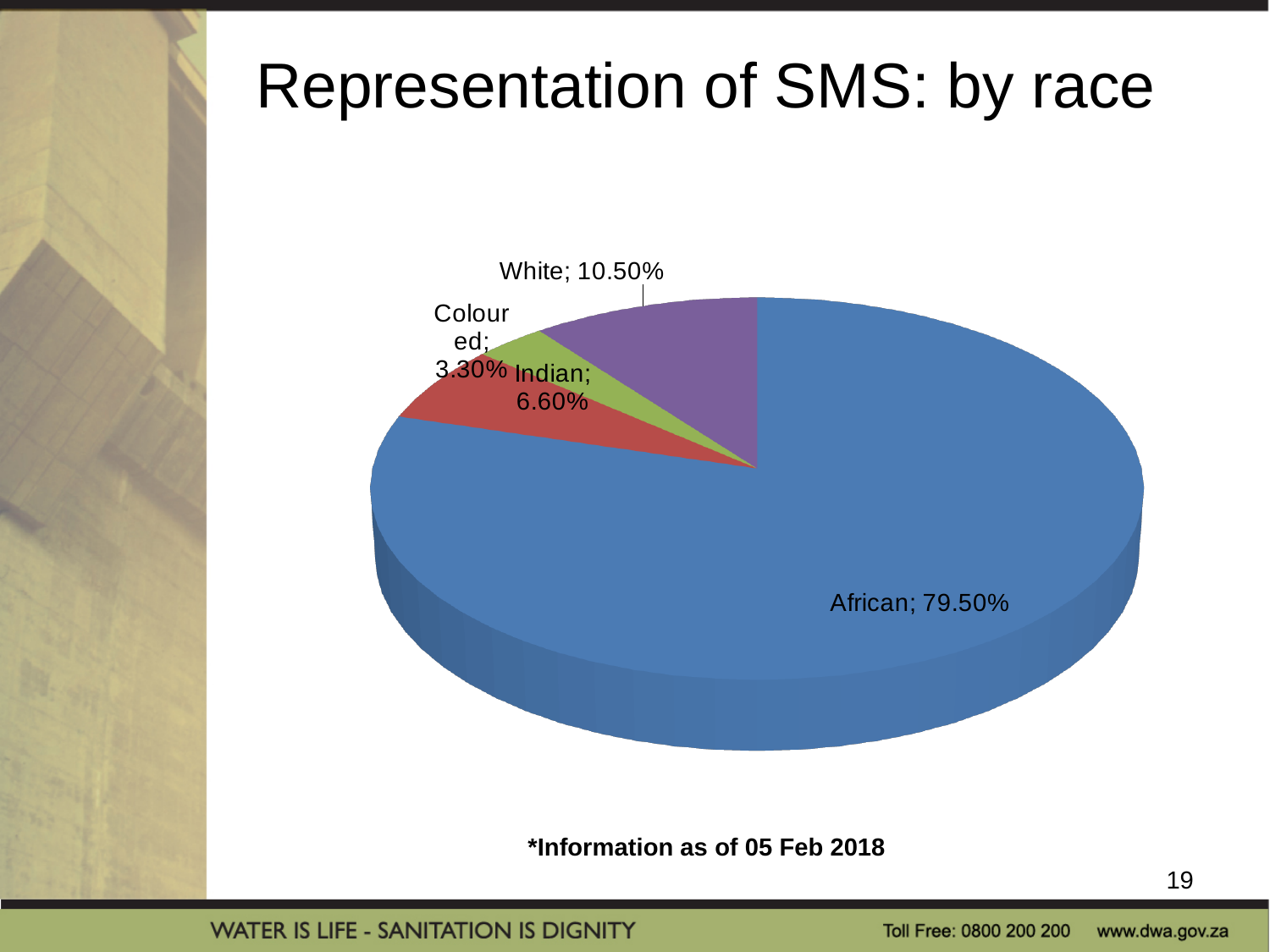
Which race group has the largest slice of the pie? African What is the difference between the White and Indian percentages? 3.90% What is the value shown for Indian? 6.60% What is the difference between the African and White percentages? 69.00% What is the value shown for Coloured? 3.30% How many race categories are shown in the pie chart? 4 What is the title of the chart on the slide? Representation of SMS: by race What kind of chart is shown on the slide? Pie chart What is the value shown for White? 10.50% Which race group has the smallest slice of the pie? Coloured What share of the pie does African represent? 79.50% Which is larger, the Indian slice or the Coloured slice? Indian